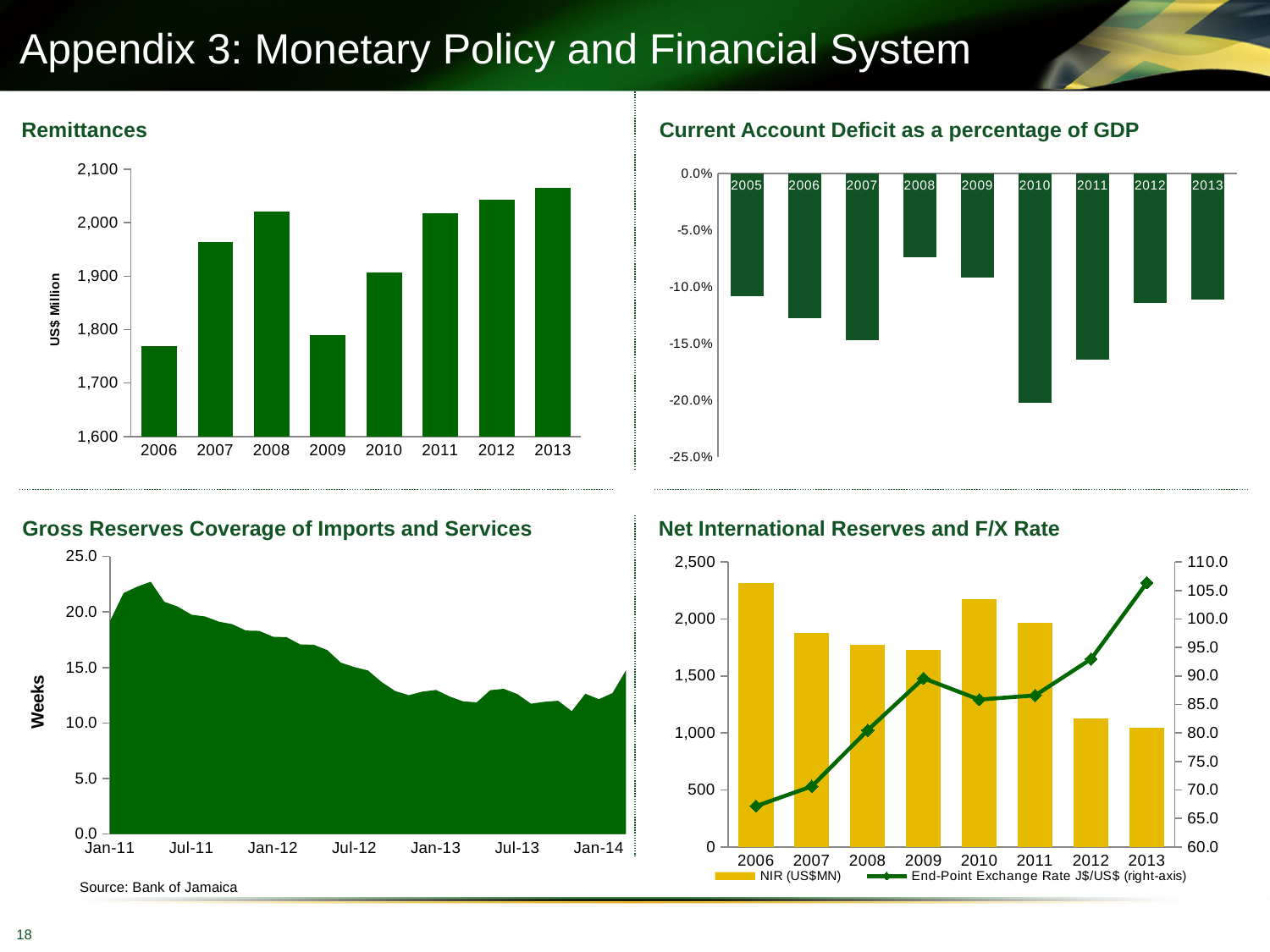
On the Gross Reserves Coverage of Imports and Services chart, do the values generally rise or fall from Jan-11 to Jan-14? fall On the Net International Reserves and F/X Rate chart, how many series does the legend list? 2 On the Net International Reserves and F/X Rate chart, is the End-Point Exchange Rate for 2013 greater or less than 100.0? greater On the Current Account Deficit as a percentage of GDP chart, how many years are shown? 9 On the Remittances chart, is the value for 2008 greater or less than 2,000? greater On the Current Account Deficit as a percentage of GDP chart, which year has the largest deficit (most negative value)? 2010 On the Net International Reserves and F/X Rate chart, which year has the highest NIR (US$MN)? 2006 On the Gross Reserves Coverage of Imports and Services chart, is the value at Jul-13 greater or less than 15.0 weeks? less On the Remittances chart, which year has the lowest value? 2006 On the Remittances chart, which year has the highest value? 2013